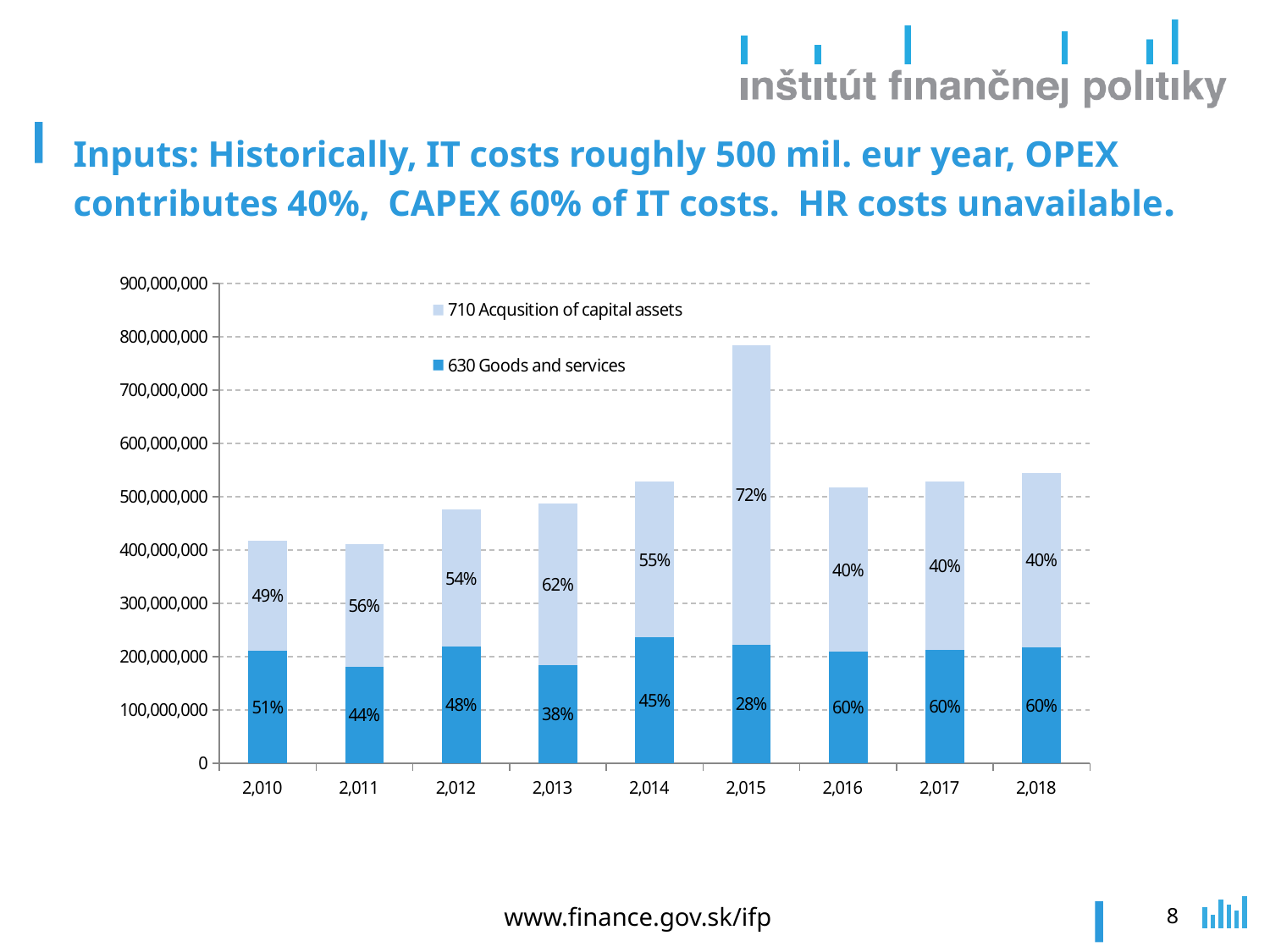
Is the total bar for 2015 greater or less than 700,000,000? greater What percentage label is shown for 710 Acquisition of capital assets in 2015? 72% In which year is the 630 Goods and services percentage label the lowest? 2015 How many years are shown on the x axis of the chart? 9 In 2013, how many percentage points higher is the 710 Acquisition of capital assets label than the 630 Goods and services label? 24 percentage points What kind of chart is shown on the slide? Stacked bar chart Which year has the taller total bar, 2015 or 2016? 2015 How many series does the chart legend list? 2 What percentage label is shown for 630 Goods and services in 2017? 60% What percentage label is shown for 630 Goods and services in 2013? 38% Which year has the tallest total bar? 2015 Is the total bar for 2010 greater or less than 500,000,000? less